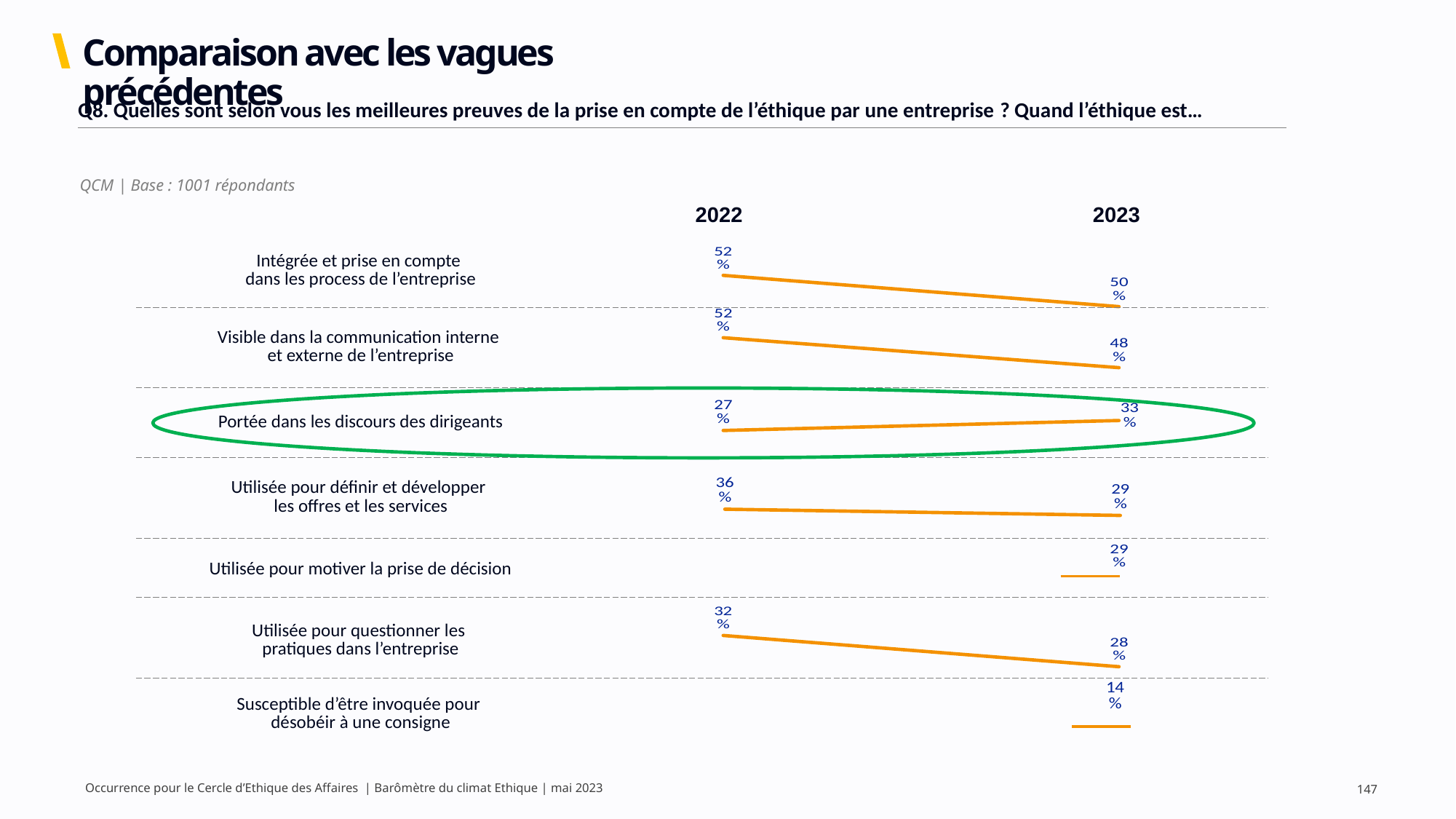
Which item has the lowest 2023 value? Susceptible d'être invoquée pour désobéir à une consigne What is the difference between the 2022 and 2023 values for "Utilisée pour définir et développer les offres et les services"? 7 points Which item is circled in green on the slide? Portée dans les discours des dirigeants What was the 2023 value for "Portée dans les discours des dirigeants"? 33% What was the 2023 value for "Susceptible d'être invoquée pour désobéir à une consigne"? 14% What was the 2022 value for "Utilisée pour définir et développer les offres et les services"? 36% By how many percentage points did "Portée dans les discours des dirigeants" change from 2022 to 2023? 6 points (27% to 33%) Which item has the highest 2023 value? Intégrée et prise en compte dans les process de l'entreprise Did the value for "Portée dans les discours des dirigeants" rise or fall from 2022 to 2023? Rise Which is larger: the 2023 value for "Visible dans la communication interne et externe de l'entreprise" or the 2023 value for "Utilisée pour questionner les pratiques dans l'entreprise"? Visible dans la communication interne et externe de l'entreprise (48%) What was the 2022 value for "Utilisée pour questionner les pratiques dans l'entreprise"? 32% How many items (categories) are listed in the chart? 7